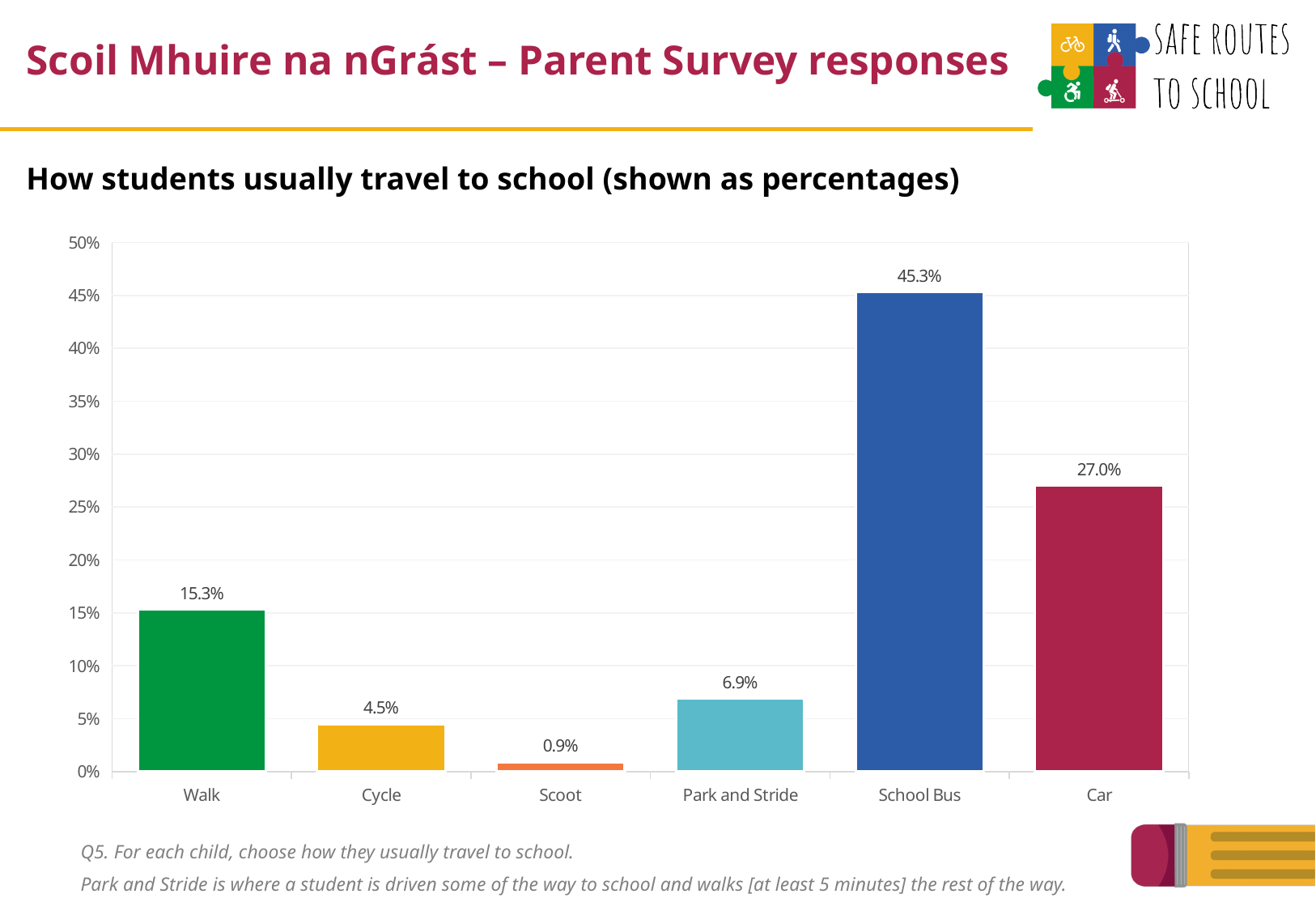
Is the value for Car greater or less than 25%? greater Which is larger, the value for Cycle or the value for Park and Stride? Park and Stride What percentage of students usually travel to school by car? 27.0% What is the value shown for Park and Stride? 6.9% Which travel mode has the lowest percentage? Scoot What is the difference in percentage points between School Bus and Car? 18.3 Which travel mode has the highest percentage? School Bus How many travel modes are shown on the x axis? 6 What percentage of students usually walk to school? 15.3% What is the title of the chart? How students usually travel to school (shown as percentages) What is the value shown for School Bus? 45.3% What kind of chart is shown on the slide? Bar chart